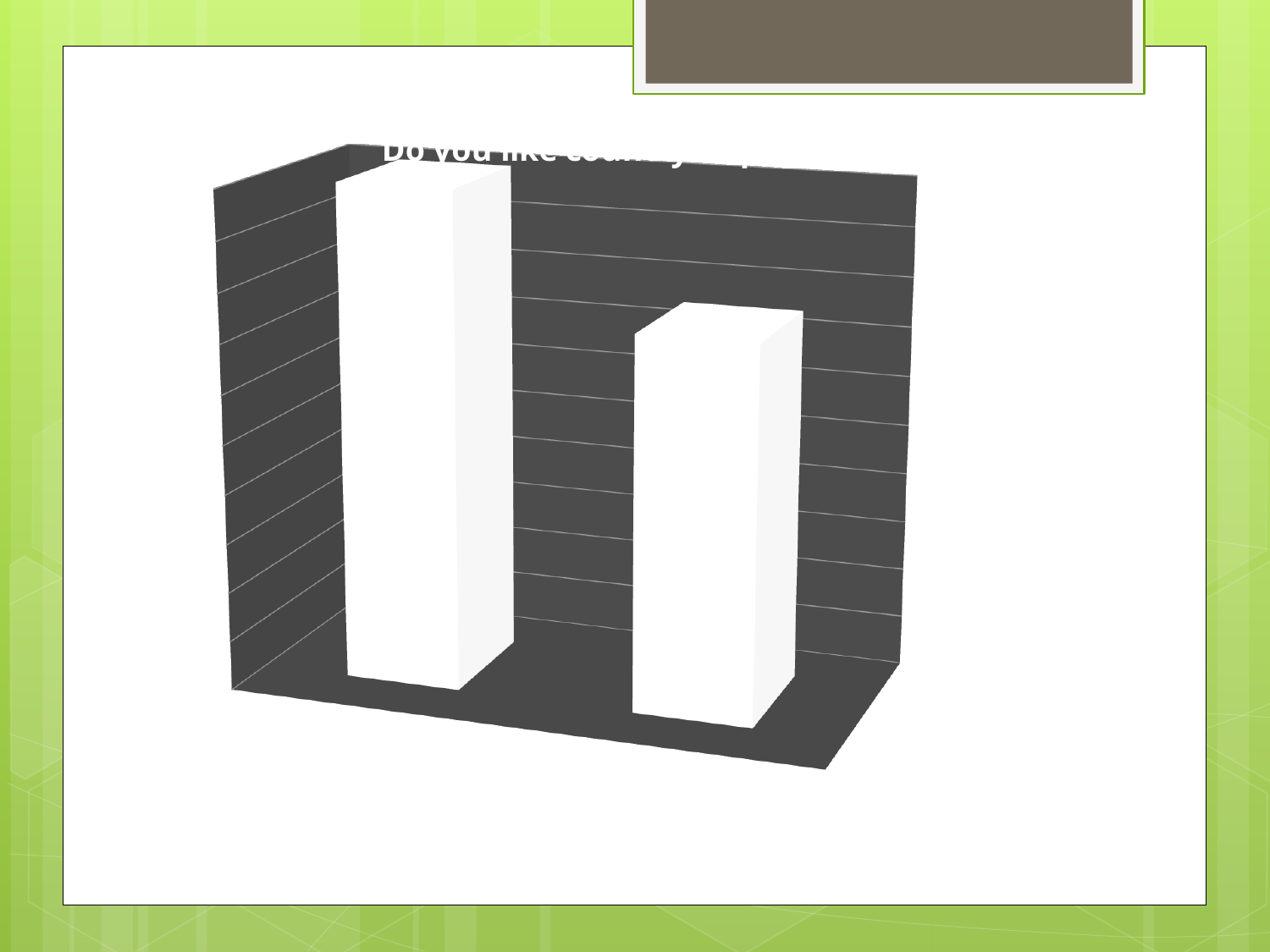
What kind of chart is shown on the slide? bar chart What colour are the bars in the chart? white How many bars are plotted in the chart? 2 Which bar is taller, the left bar or the right bar? the left bar Which bar has the lowest value, the left one or the right one? the right bar Do the bar values rise or fall from left to right across the chart? fall